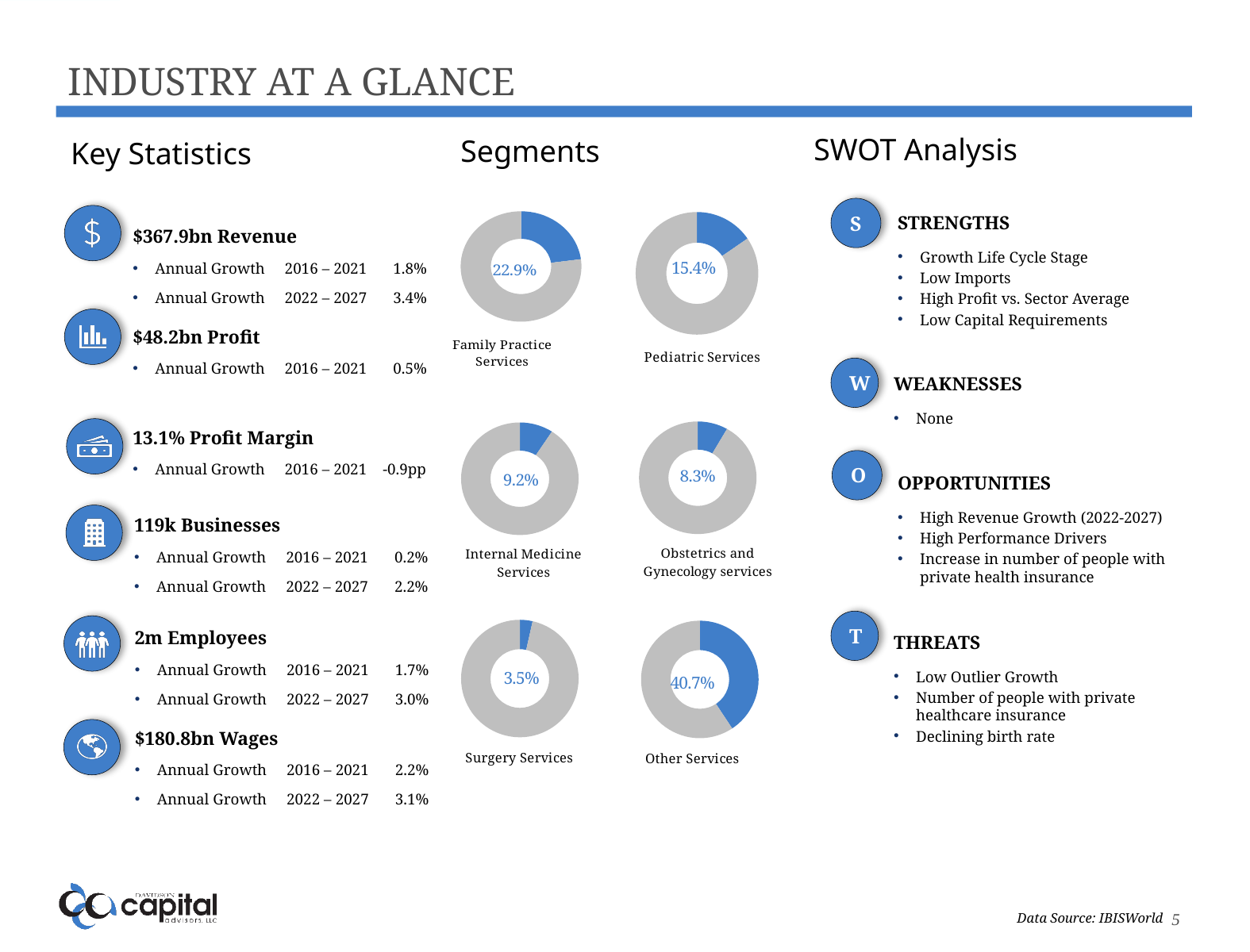
In the Segments section, which has a larger share: Family Practice Services or Pediatric Services? Family Practice Services What kind of chart is used to show each segment in the Segments section? Donut (pie) chart Among the six segment donut charts, which segment has the lowest percentage? Surgery Services In the Segments section, what is the difference between the Family Practice Services percentage and the Pediatric Services percentage? 7.5% In the Segments section, what percentage is shown on the Surgery Services donut chart? 3.5% In the Segments section, what percentage is shown on the Pediatric Services donut chart? 15.4% How many donut charts are shown in the Segments section? 6 Among the six segment donut charts, which segment has the highest percentage? Other Services In the Segments section, what percentage is shown on the Family Practice Services donut chart? 22.9% In the Segments section, what percentage is shown on the Obstetrics and Gynecology services donut chart? 8.3% In the Segments section, what percentage is shown on the Internal Medicine Services donut chart? 9.2% In the Segments section, what percentage is shown on the Other Services donut chart? 40.7%